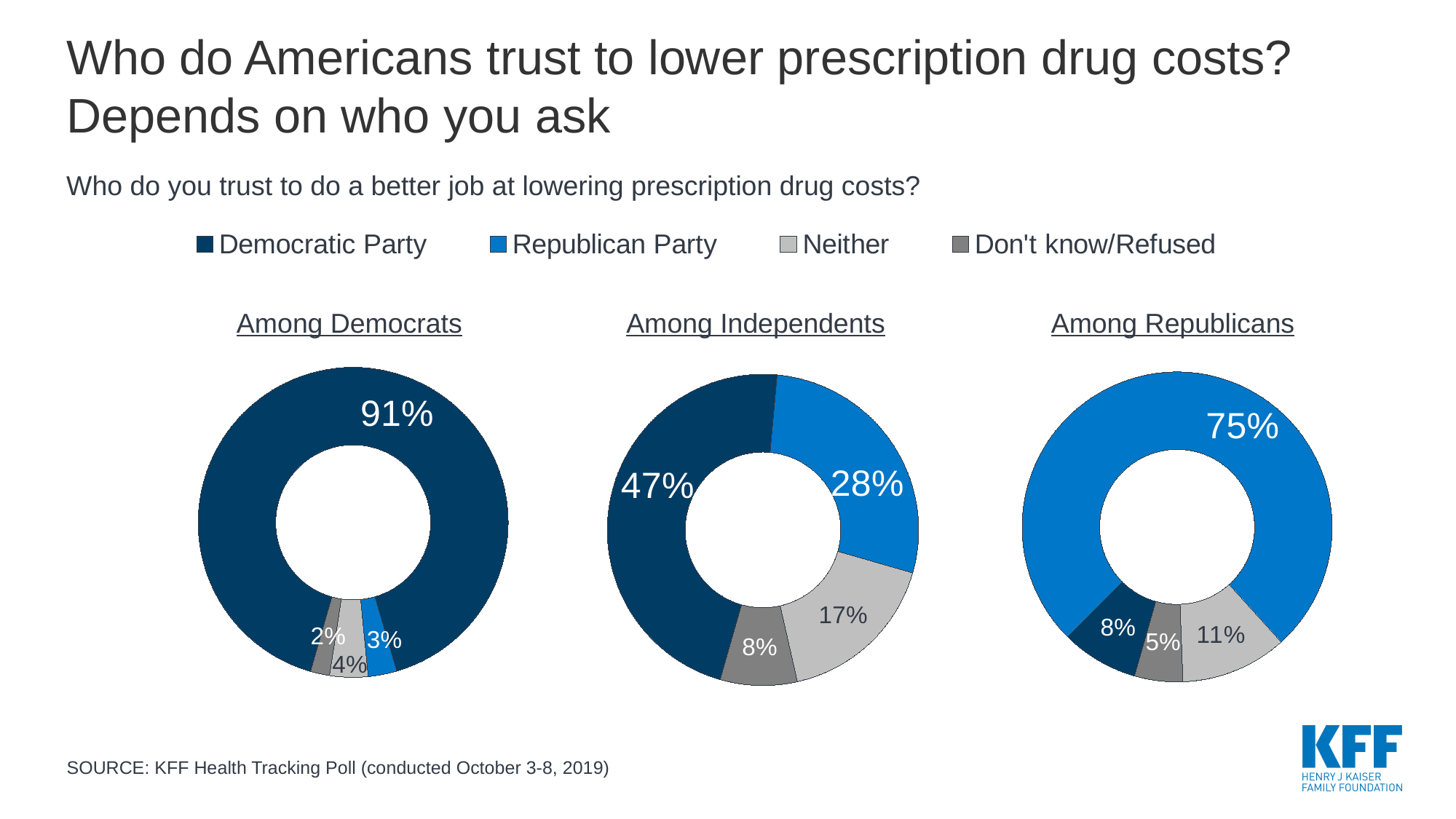
In the 'Among Republicans' chart, what share trusts the Republican Party? 75% How many series does the legend list? 4 In the 'Among Democrats' chart, which response has the smallest share? Don't know/Refused In the 'Among Independents' chart, which response has the largest share? Democratic Party In the 'Among Republicans' chart, what share trusts the Democratic Party? 8% In the 'Among Independents' chart, what share answered Neither? 17% In the 'Among Independents' chart, what share trusts the Republican Party? 28% What kind of chart is used on this slide? Donut (pie) chart In the 'Among Republicans' chart, which is larger: the Neither share or the Don't know/Refused share? Neither How many charts are shown on the slide? 3 In the 'Among Democrats' chart, what share trusts the Democratic Party? 91% In the 'Among Independents' chart, what is the difference between the Democratic Party share and the Republican Party share? 19 percentage points